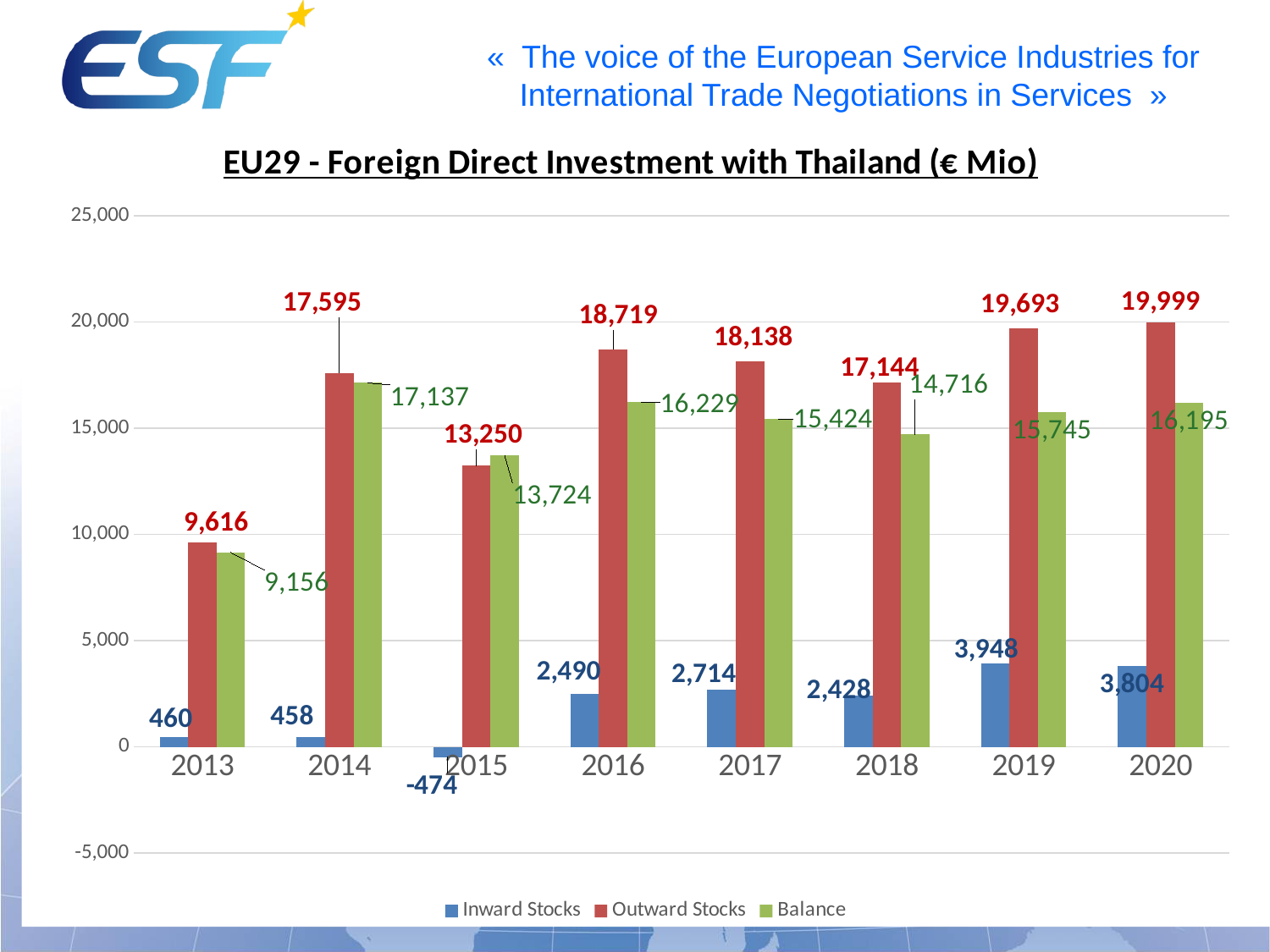
What kind of chart is shown on the slide? Bar chart What is the value of Inward Stocks in 2015? -474 Which series is shown in green? Balance Is the Outward Stocks value for 2014 greater or less than 15,000? greater What is the value of Outward Stocks in 2020? 19,999 How many series does the legend list? 3 In which year are Outward Stocks highest? 2020 In which year is the Balance lowest? 2013 What is the Balance value for 2018? 14,716 Which is larger: Inward Stocks in 2019 or Inward Stocks in 2020? 2019 What is the difference between Outward Stocks in 2019 and 2018? 2,549 How many years are shown on the x axis? 8